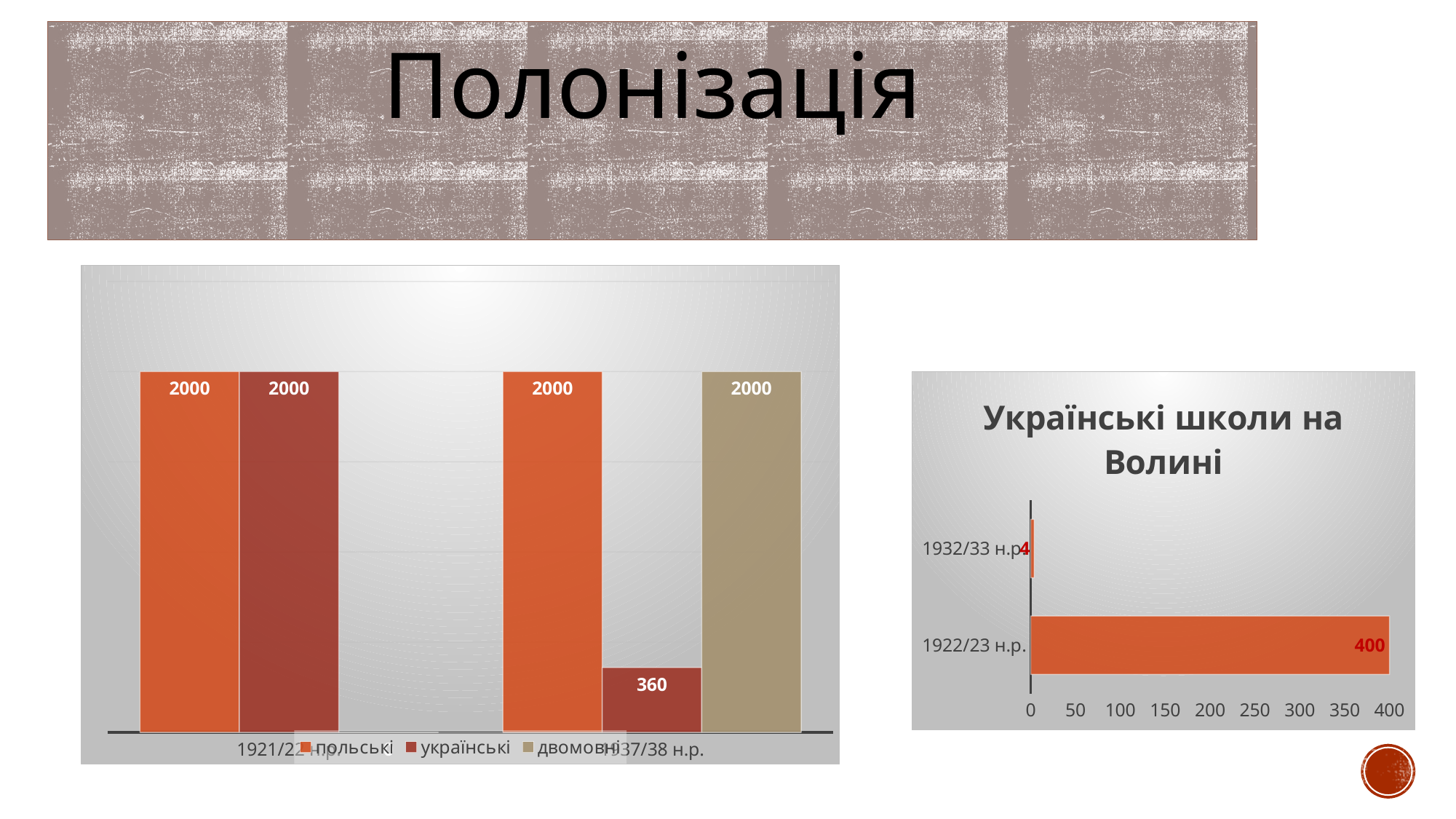
In the chart titled 'Українські школи на Волині', which category has the lowest value? 1932/33 н.р. In the left chart, which is larger in 1937/38 н.р.: двомовні or українські? двомовні In the chart titled 'Українські школи на Волині', how many categories are shown? 2 In the chart titled 'Українські школи на Волині', what is the value for 1932/33 н.р.? 4 In the left chart, what is the value for українські in 1937/38 н.р.? 360 In the left chart, how many series does the legend list? 3 What kind of chart is the chart titled 'Українські школи на Волині'? Bar chart In the left chart, what is the value for польські in 1921/22 н.р.? 2000 In the left chart, which series is shown in the tan/beige colour? двомовні In the chart titled 'Українські школи на Волині', what is the difference between the values for 1922/23 н.р. and 1932/33 н.р.? 396 In the left chart, what is the difference between the польські and українські values in 1937/38 н.р.? 1640 In the chart titled 'Українські школи на Волині', what is the value for 1922/23 н.р.? 400